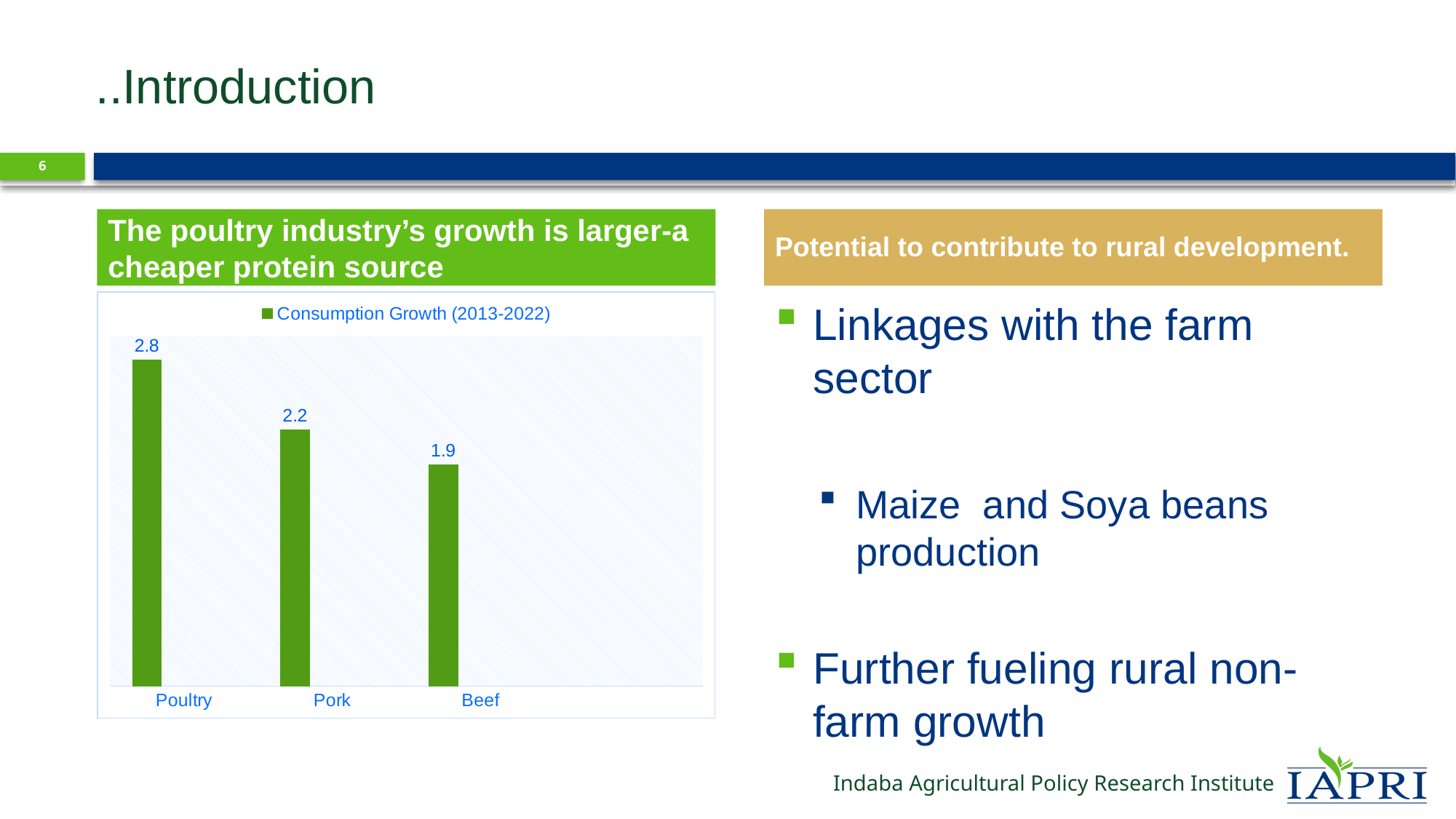
How many categories are shown in the chart? 3 What is the difference between the consumption growth values for Poultry and Beef? 0.9 What is the consumption growth value for Beef? 1.9 How many series does the legend list? 1 Which category has the highest consumption growth? Poultry Which has a larger consumption growth value, Pork or Beef? Pork What kind of chart is shown on the slide? Bar chart What is the consumption growth value for Pork? 2.2 What is the consumption growth value for Poultry? 2.8 What is the difference between the consumption growth values for Pork and Beef? 0.3 Which category has the lowest consumption growth? Beef What is the legend entry of the chart? Consumption Growth (2013-2022)